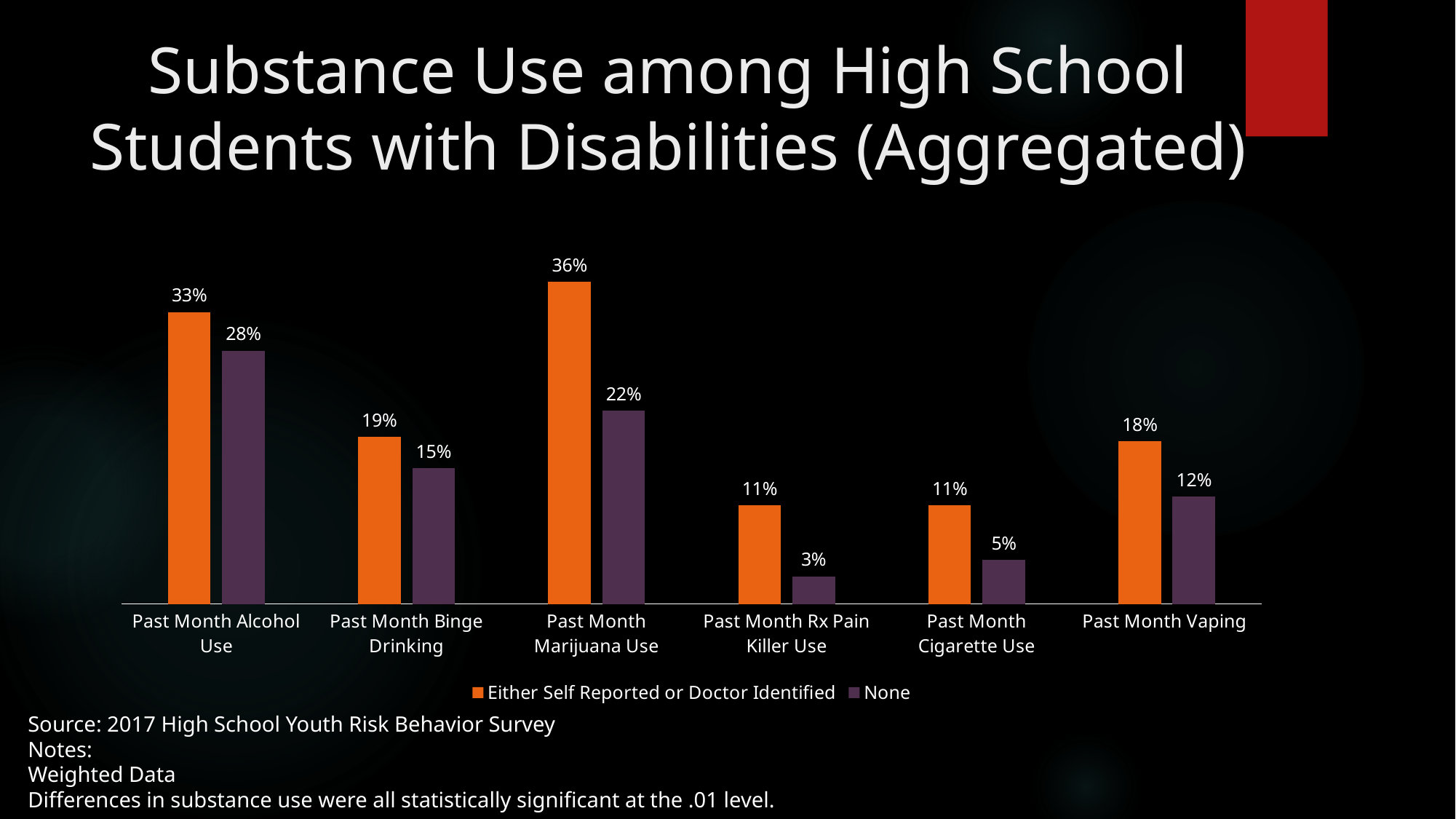
What is the value for Past Month Marijuana Use in the Either Self Reported or Doctor Identified series? 36% Which is larger: the None value for Past Month Binge Drinking or the None value for Past Month Vaping? Past Month Binge Drinking What is the value for Past Month Rx Pain Killer Use in the None series? 3% How many series does the legend list? 2 What is the difference between the Either Self Reported or Doctor Identified value and the None value for Past Month Cigarette Use? 6% What is the source cited below the chart? 2017 High School Youth Risk Behavior Survey Which category has the lowest value in the None series? Past Month Rx Pain Killer Use What is the difference between the Either Self Reported or Doctor Identified value and the None value for Past Month Alcohol Use? 5% What is the value for Past Month Vaping in the None series? 12% How many categories are shown on the x axis? 6 Which category has the highest value in the Either Self Reported or Doctor Identified series? Past Month Marijuana Use What kind of chart is shown on the slide? Bar chart